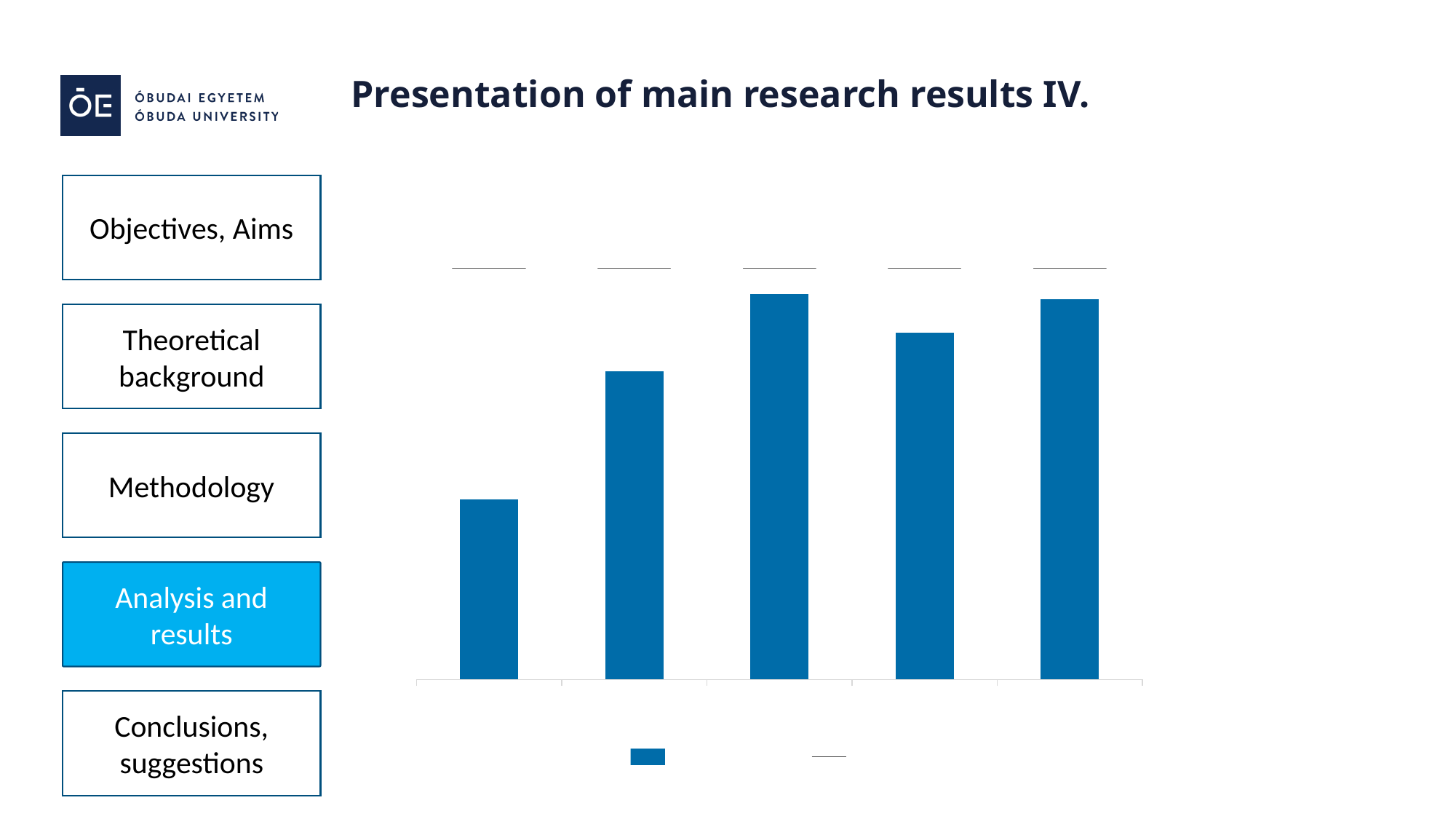
How many entries does the chart's legend show? 2 Which is taller in the chart, the second bar from the left or the fourth bar? the fourth bar Which bar, counted from the left, is the lowest in the chart? the first bar Which is taller in the chart, the second bar from the left or the third bar? the third bar What colour are the bars in the chart? blue Do the bars rise steadily from left to right across the chart? no How many bars are plotted in the chart? 5 What kind of chart is shown on the slide? bar chart Which is taller in the chart, the first bar from the left or the second bar? the second bar